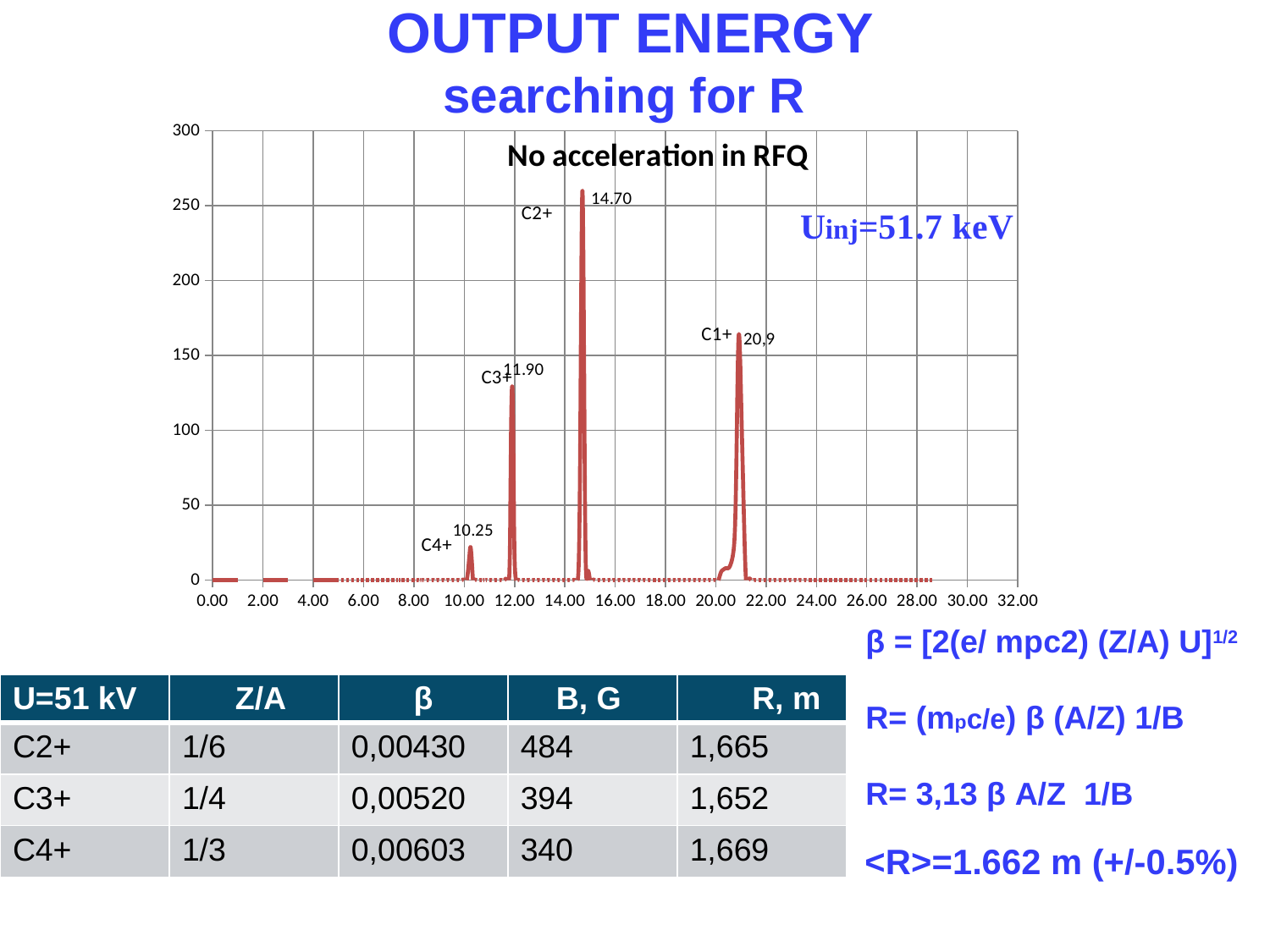
Which labelled peak is the shortest? C4+ What x-axis value is labelled at the C3+ peak? 11.90 Which labelled peak is the tallest? C2+ Is the height of the C4+ peak greater or less than 50? less What kind of chart is shown on the slide? line chart Is the height of the C3+ peak greater or less than 150? less Is the height of the C2+ peak greater or less than 250? greater What x-axis value is labelled at the C2+ peak? 14.70 What x-axis value is labelled at the C1+ peak? 20,9 Which peak is taller, C1+ or C3+? C1+ How many labelled peaks are shown on the chart? 4 What x-axis value is labelled at the C4+ peak? 10.25